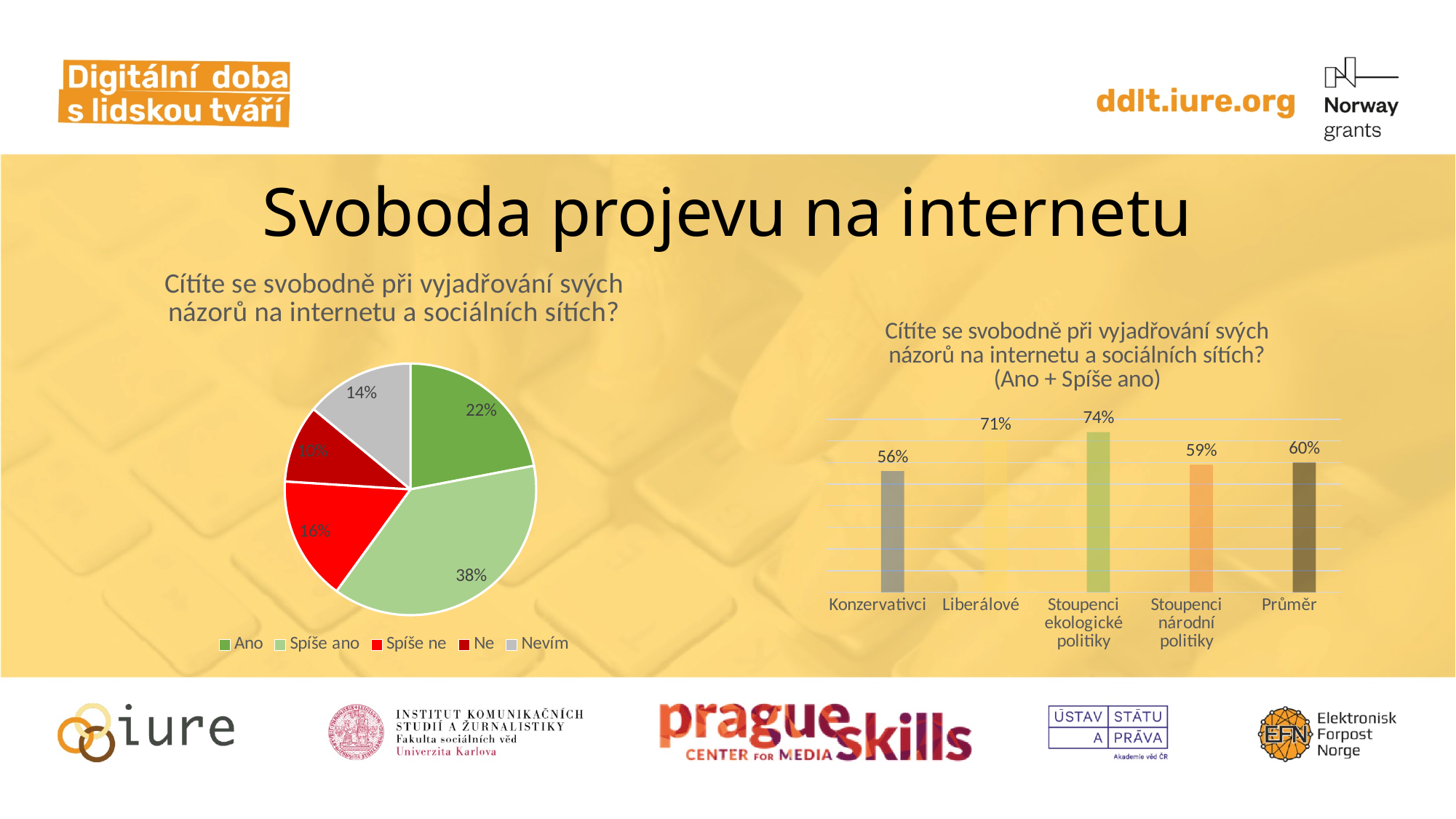
In the bar chart on the right, which category has the lowest value? Konzervativci What kind of chart is the chart on the right of the slide? Bar chart How many entries does the legend of the pie chart on the left list? 5 In the bar chart on the right, what is the value for Stoupenci ekologické politiky? 74% In the pie chart on the left, which answer has the smallest share? Ne In the pie chart on the left, which answer has the largest share? Spíše ano In the bar chart on the right, what is the value for Konzervativci? 56% In the pie chart on the left, what is the combined share of "Ano" and "Spíše ano"? 60% How many categories are shown on the x axis of the bar chart on the right? 5 In the bar chart on the right, what is the difference between the values for Liberálové and Stoupenci národní politiky? 12% In the pie chart on the left, what share of respondents answered "Spíše ano"? 38% In the pie chart on the left, what share of respondents answered "Nevím"? 14%